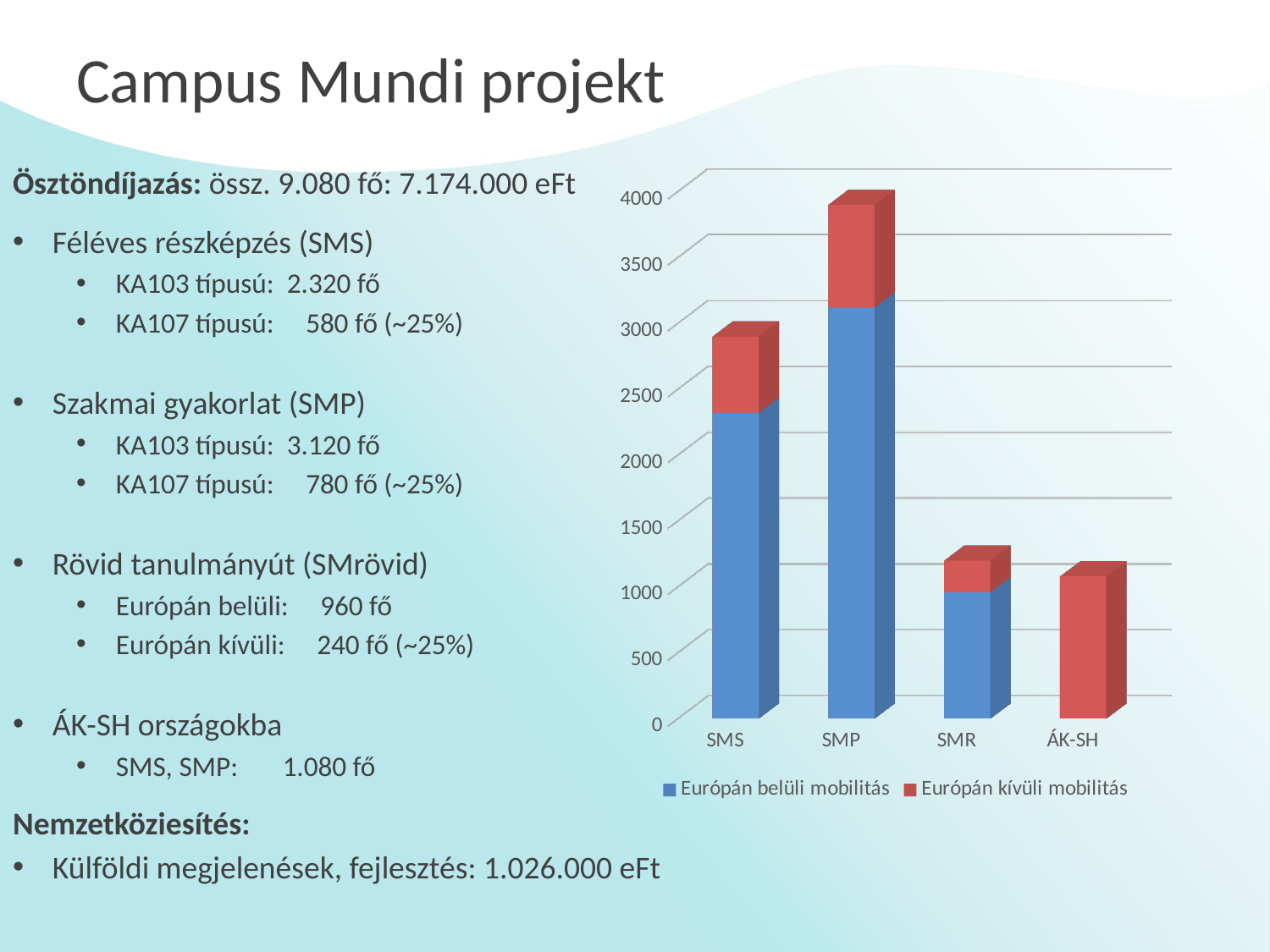
Which category has the tallest stacked bar in the chart? SMP Which category has the shortest stacked bar in the chart? ÁK-SH How many categories are shown on the x axis of the chart? 4 Is the Európán belüli mobilitás value for SMS greater or less than 2000? greater Is the total stacked value for SMS greater or less than 2500? greater Which category in the chart has no Európán belüli mobilitás segment? ÁK-SH Is the total stacked value for SMP greater or less than 3500? greater Which colour represents Európán kívüli mobilitás in the chart? red What kind of chart is shown on the slide? bar chart How many series does the chart legend list? 2 Which stacked bar is taller, SMS or SMR? SMS